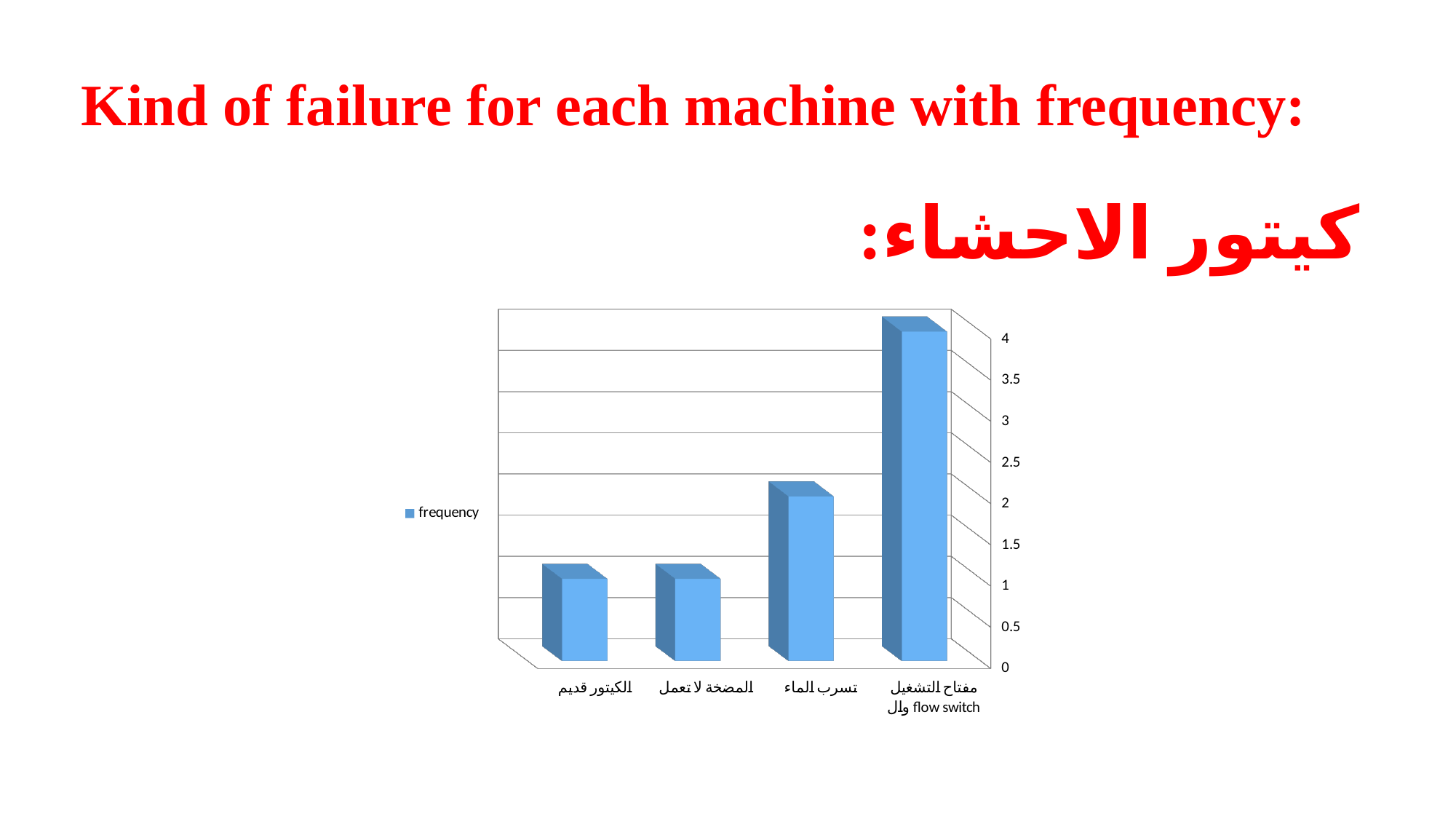
Which category has the highest frequency in the chart? مفتاح التشغيل والـ flow switch Which has a larger frequency, تسرب الماء or الكيتور قديم? تسرب الماء Is the frequency for مفتاح التشغيل والـ flow switch greater or less than 3? greater What is the frequency value for تسرب الماء? 2 How many categories are plotted on the x axis of the chart? 4 What is the English title written above the chart on the slide? Kind of failure for each machine with frequency: What is the difference in frequency between مفتاح التشغيل والـ flow switch and تسرب الماء? 2 What is the frequency value for مفتاح التشغيل والـ flow switch? 4 How many series does the chart's legend list? 1 What kind of chart is shown on the slide? bar chart Is the frequency for الكيتور قديم greater or less than 2? less What is the name of the series shown in the chart's legend? frequency